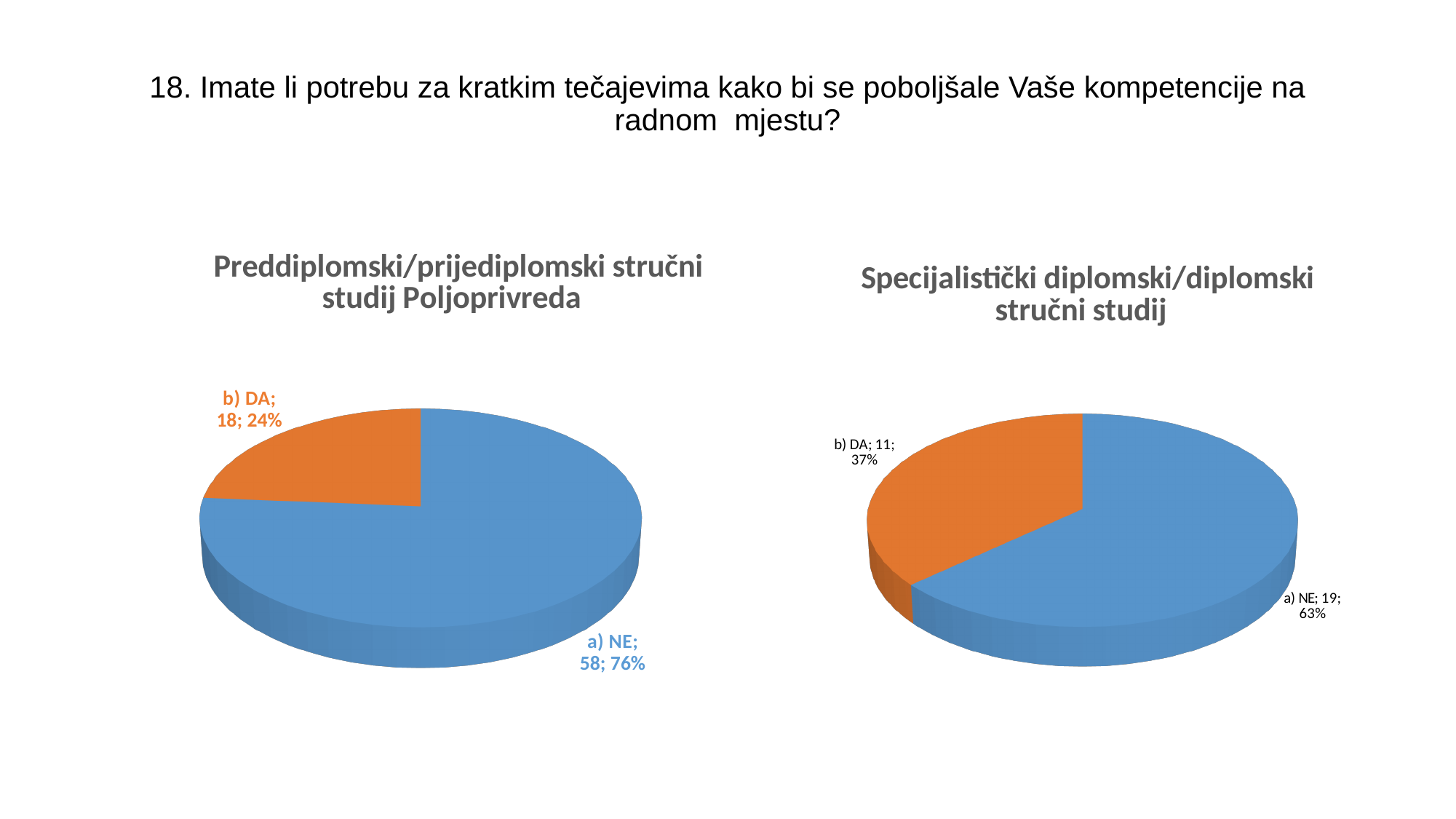
In the left chart (Preddiplomski/prijediplomski stručni studij Poljoprivreda), what colour is the a) NE slice? Blue In the right chart (Specijalistički diplomski/diplomski stručni studij), what percentage share does a) NE have? 63% In the left chart (Preddiplomski/prijediplomski stručni studij Poljoprivreda), what percentage share does b) DA have? 24% In the left chart (Preddiplomski/prijediplomski stručni studij Poljoprivreda), which answer has the largest slice? a) NE In the left chart (Preddiplomski/prijediplomski stručni studij Poljoprivreda), how many slices does the pie have? 2 What type of chart is shown on the right side of the slide (Specijalistički diplomski/diplomski stručni studij)? Pie chart In the right chart (Specijalistički diplomski/diplomski stručni studij), how many respondents answered b) DA? 11 In the right chart (Specijalistički diplomski/diplomski stručni studij), what is the total number of responses shown? 30 Which is larger: the number of b) DA responses in the left chart or the number of b) DA responses in the right chart? Left chart (18) In the right chart (Specijalistički diplomski/diplomski stručni studij), which answer has the smallest slice? b) DA In the left chart (Preddiplomski/prijediplomski stručni studij Poljoprivreda), what is the difference between the number of a) NE and b) DA responses? 40 In the left chart (Preddiplomski/prijediplomski stručni studij Poljoprivreda), how many respondents answered a) NE? 58